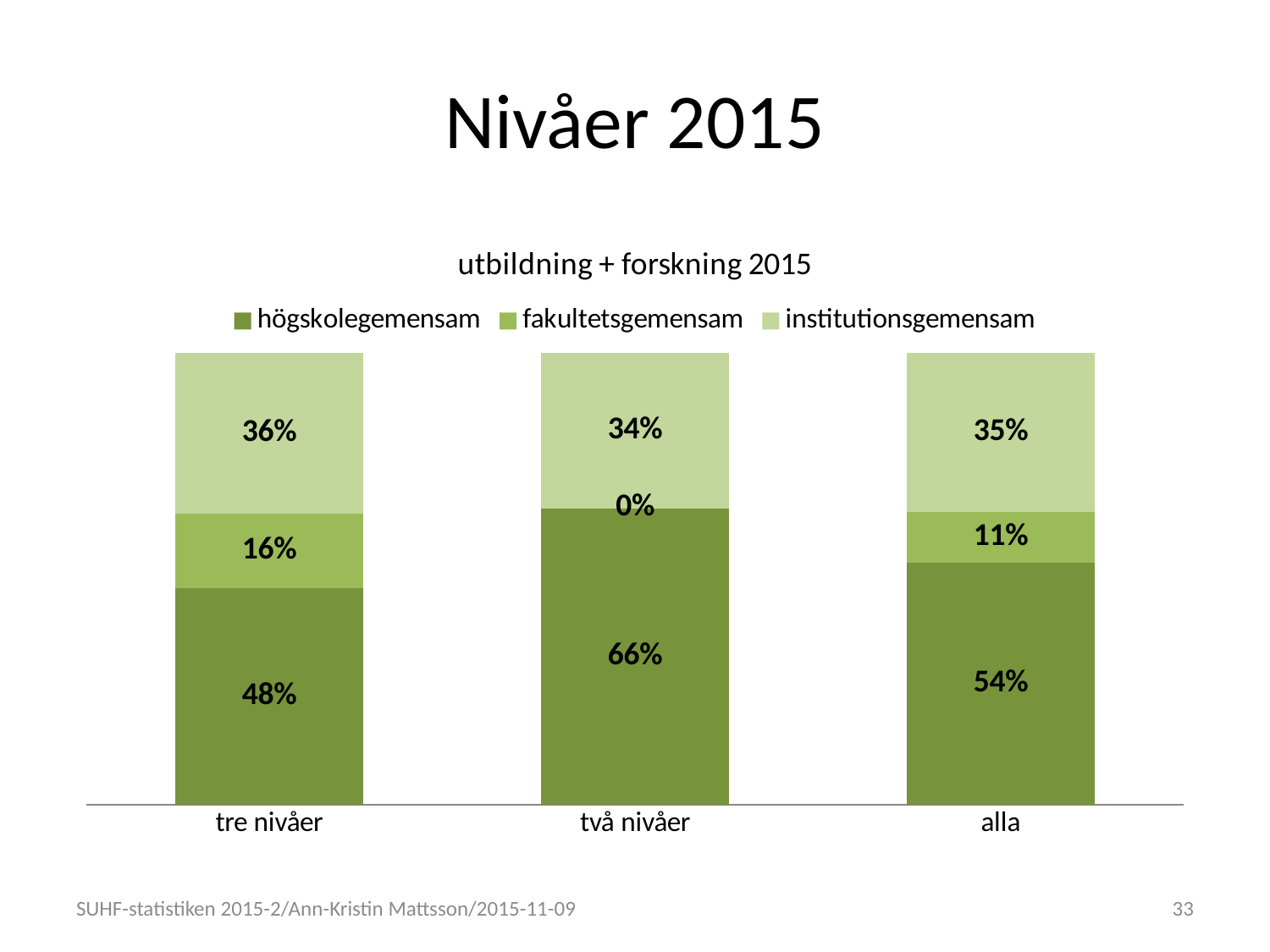
How many series does the legend list? 3 What kind of chart is shown on the slide? stacked bar chart Which is larger, the institutionsgemensam value for tre nivåer or for två nivåer? tre nivåer Which category has the lowest fakultetsgemensam value? två nivåer What is the fakultetsgemensam value for alla? 11% What is the högskolegemensam value for tre nivåer? 48% What is the institutionsgemensam value for alla? 35% How many categories are shown on the x axis? 3 What is the title of the chart? utbildning + forskning 2015 What is the difference between the högskolegemensam values for två nivåer and tre nivåer? 18% Which category has the highest högskolegemensam value? två nivåer What is the fakultetsgemensam value for två nivåer? 0%